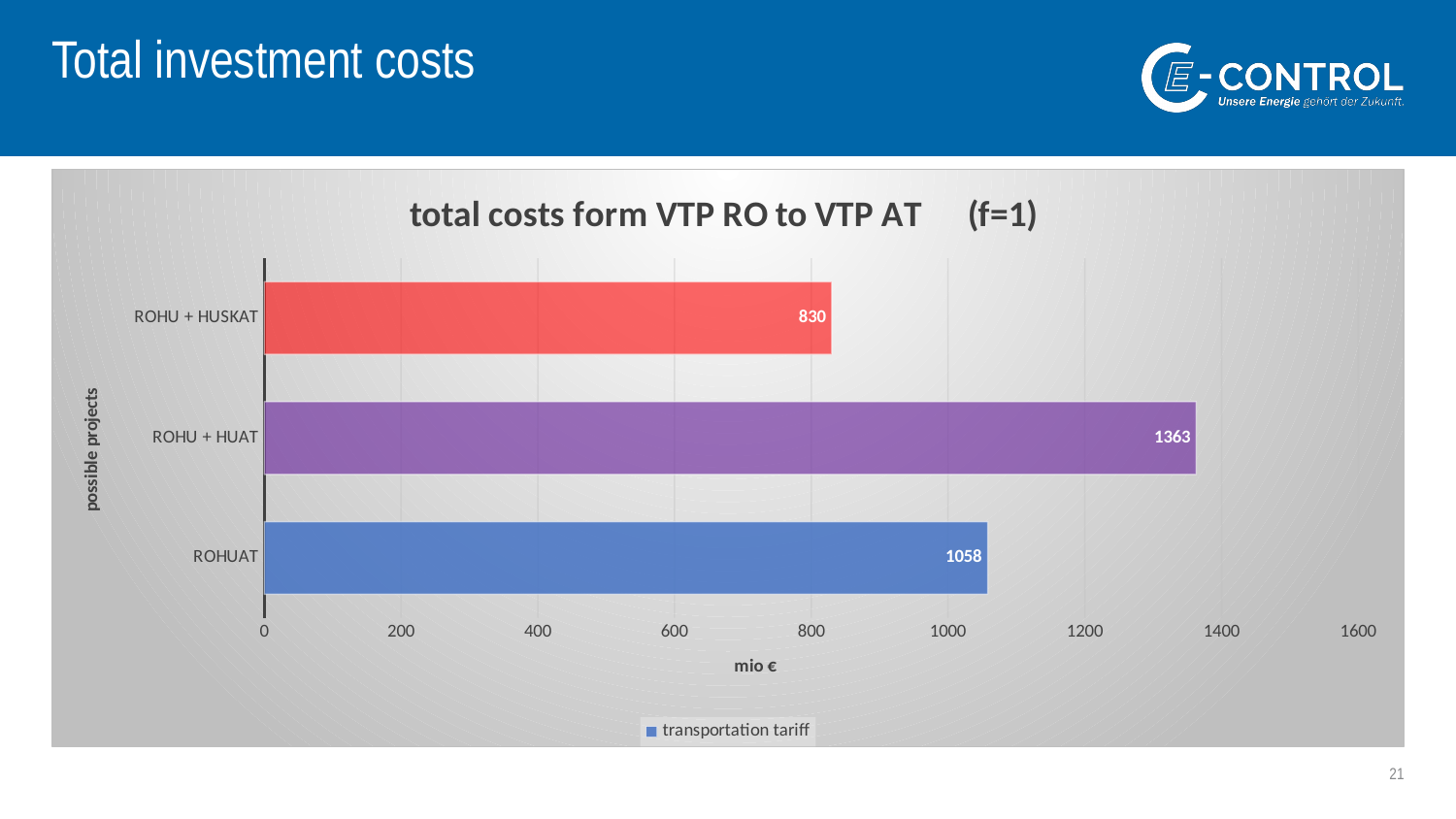
What is the value for ROHU + HUSKAT? 830 What is the value for ROHU + HUAT? 1363 How many projects are shown on the chart? 3 What is the value for ROHUAT? 1058 Which project has the lowest total cost? ROHU + HUSKAT What is the unit shown on the x axis of the chart? mio € What kind of chart is shown on the slide? bar chart Which is larger, the value for ROHUAT or the value for ROHU + HUSKAT? ROHUAT What is the difference between the values for ROHUAT and ROHU + HUSKAT? 228 Which project has the highest total cost? ROHU + HUAT What is the difference between the values for ROHU + HUAT and ROHUAT? 305 Is the value for ROHU + HUAT greater or less than 1200? greater